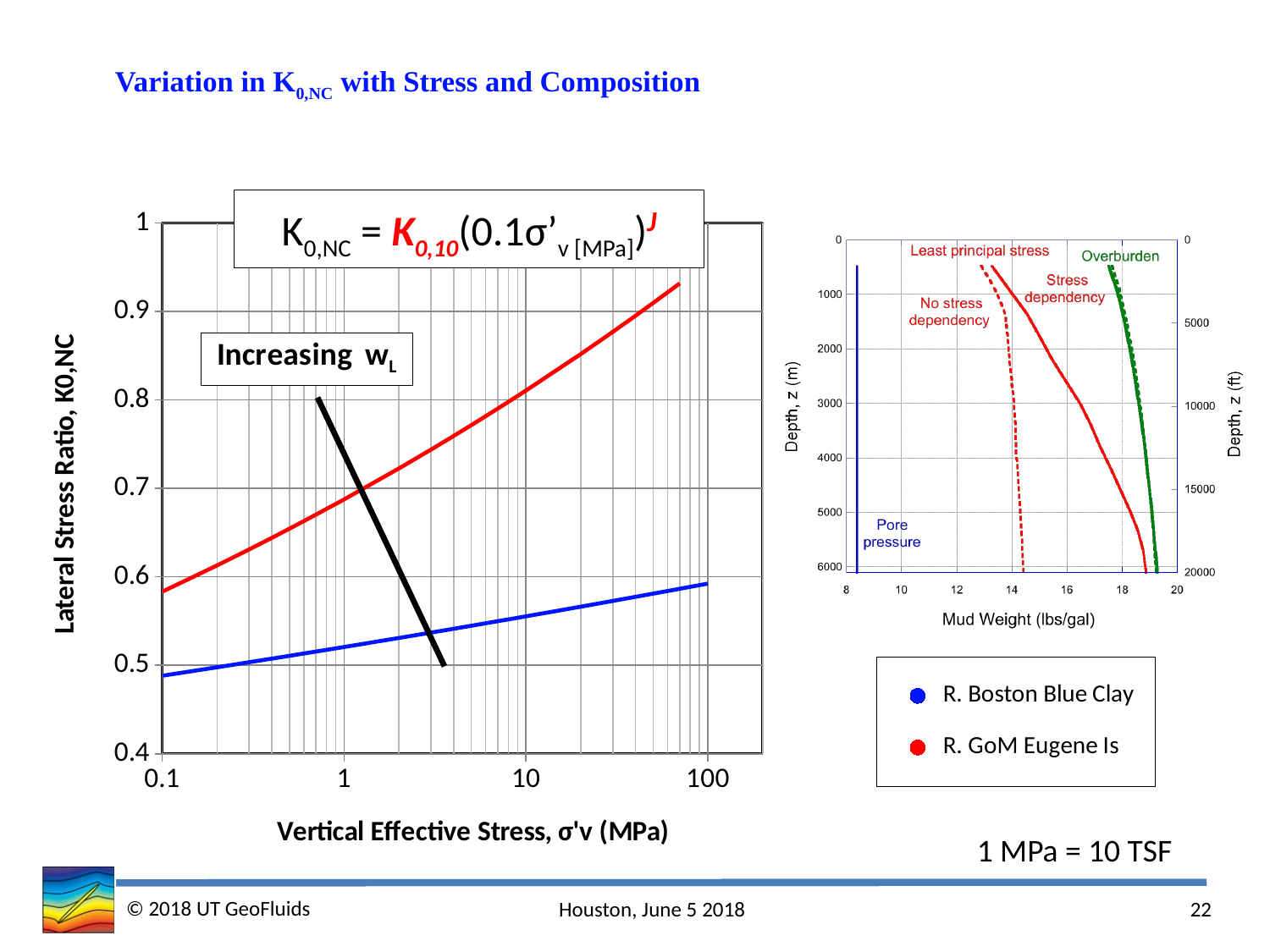
In the main chart on the left, what kind of chart is used to show K0,NC against vertical effective stress? line chart In the main chart on the left, which series has the lower K0,NC across the whole stress range shown? R. Boston Blue Clay In the main chart on the left, how many series does the legend list? 2 In the main chart on the left, is the K0,NC value for R. GoM Eugene Is at 10 MPa greater or less than 0.7? greater In the main chart on the left, at a vertical effective stress of 10 MPa, which series has the higher K0,NC: R. GoM Eugene Is or R. Boston Blue Clay? R. GoM Eugene Is In the main chart on the left, which series is drawn in red? R. GoM Eugene Is In the main chart on the left, does the K0,NC value for R. GoM Eugene Is rise or fall as vertical effective stress increases? rise In the main chart on the left, does the K0,NC value for R. Boston Blue Clay rise or fall as vertical effective stress increases? rise In the main chart on the left, which series is drawn in blue? R. Boston Blue Clay In the main chart on the left, is the K0,NC value for R. Boston Blue Clay at 100 MPa greater or less than 0.6? less In the main chart on the left, is the K0,NC value for R. GoM Eugene Is at 0.1 MPa greater or less than 0.6? less